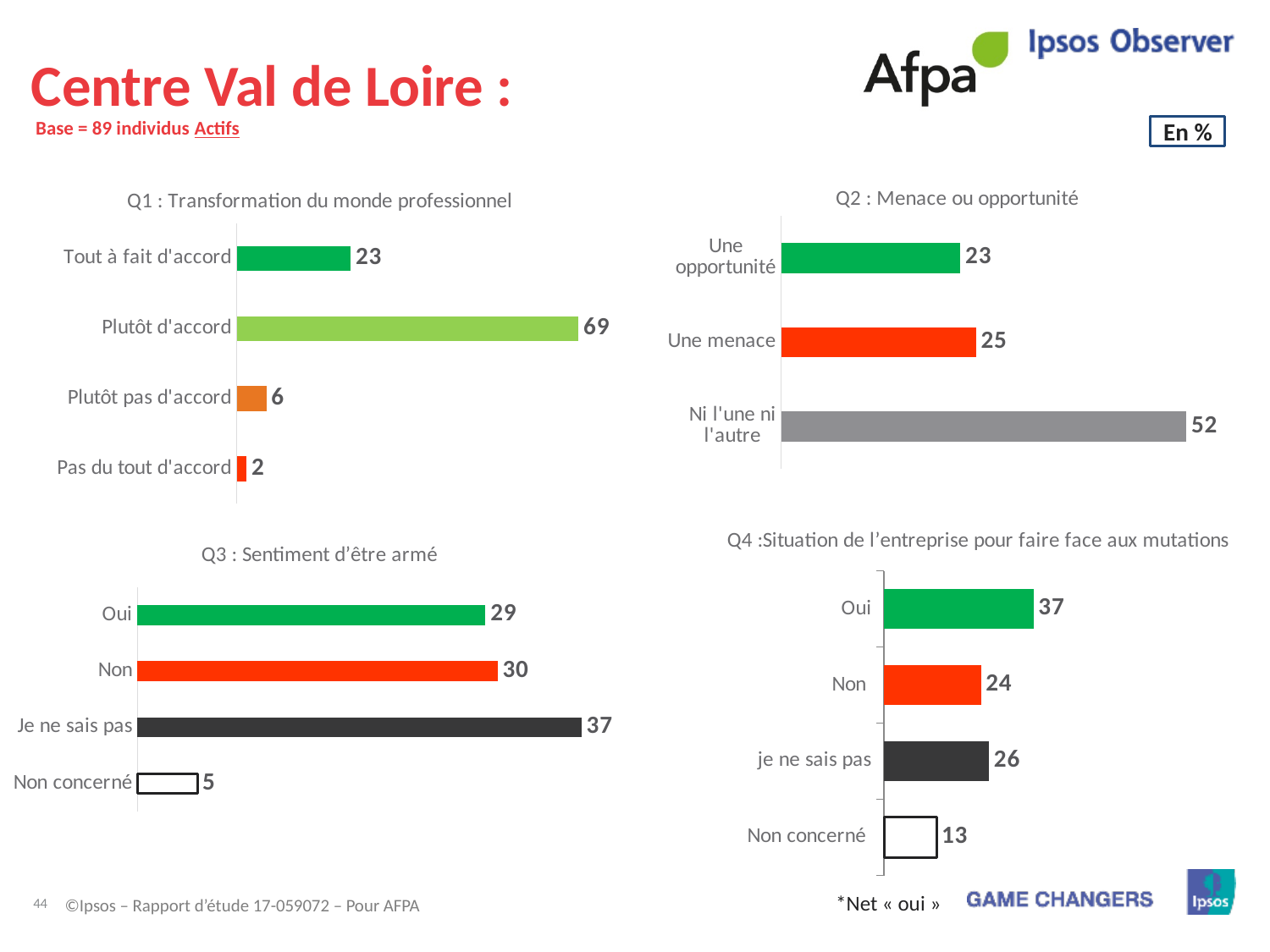
In the Q3 : Sentiment d'être armé chart, which is larger, Oui or Non? Non In the Q4 : Situation de l'entreprise pour faire face aux mutations chart, what is the value for je ne sais pas? 26 What type of chart is the Q4 : Situation de l'entreprise pour faire face aux mutations chart? Bar chart In the Q4 : Situation de l'entreprise pour faire face aux mutations chart, what is the difference between Oui and Non? 13 In the Q1 : Transformation du monde professionnel chart, which category has the lowest value? Pas du tout d'accord In the Q3 : Sentiment d'être armé chart, which category has the highest value? Je ne sais pas In the Q1 : Transformation du monde professionnel chart, how many categories are shown? 4 In the Q3 : Sentiment d'être armé chart, what is the value for Non concerné? 5 In the Q2 : Menace ou opportunité chart, which category has the highest value? Ni l'une ni l'autre In the Q1 : Transformation du monde professionnel chart, what is the value for Plutôt d'accord? 69 In the Q2 : Menace ou opportunité chart, what is the value for Ni l'une ni l'autre? 52 In the Q2 : Menace ou opportunité chart, what is the difference between Une menace and Une opportunité? 2